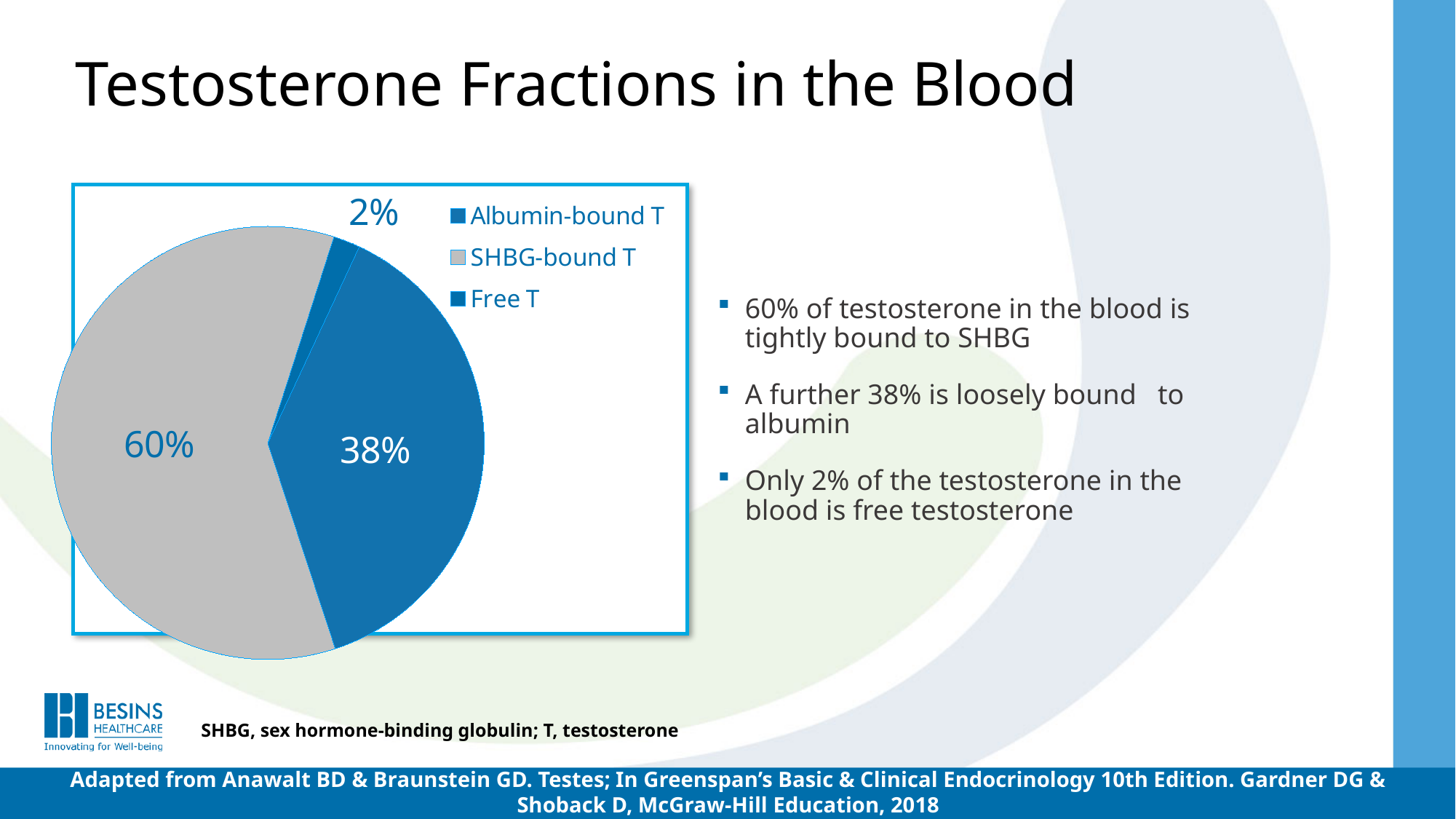
Which category has the smallest slice of the pie? Free T What is the difference between the SHBG-bound T and Albumin-bound T shares? 22% What colour is the SHBG-bound T slice? grey Which is larger, the Albumin-bound T slice or the Free T slice? Albumin-bound T Which category has the largest slice of the pie? SHBG-bound T How many entries does the legend list? 3 What kind of chart is shown on the slide? pie chart What is the difference between the Albumin-bound T and Free T shares? 36% What share of the pie is SHBG-bound T? 60% How many categories does the pie chart have? 3 What share of the pie is Albumin-bound T? 38% What share of the pie is Free T? 2%